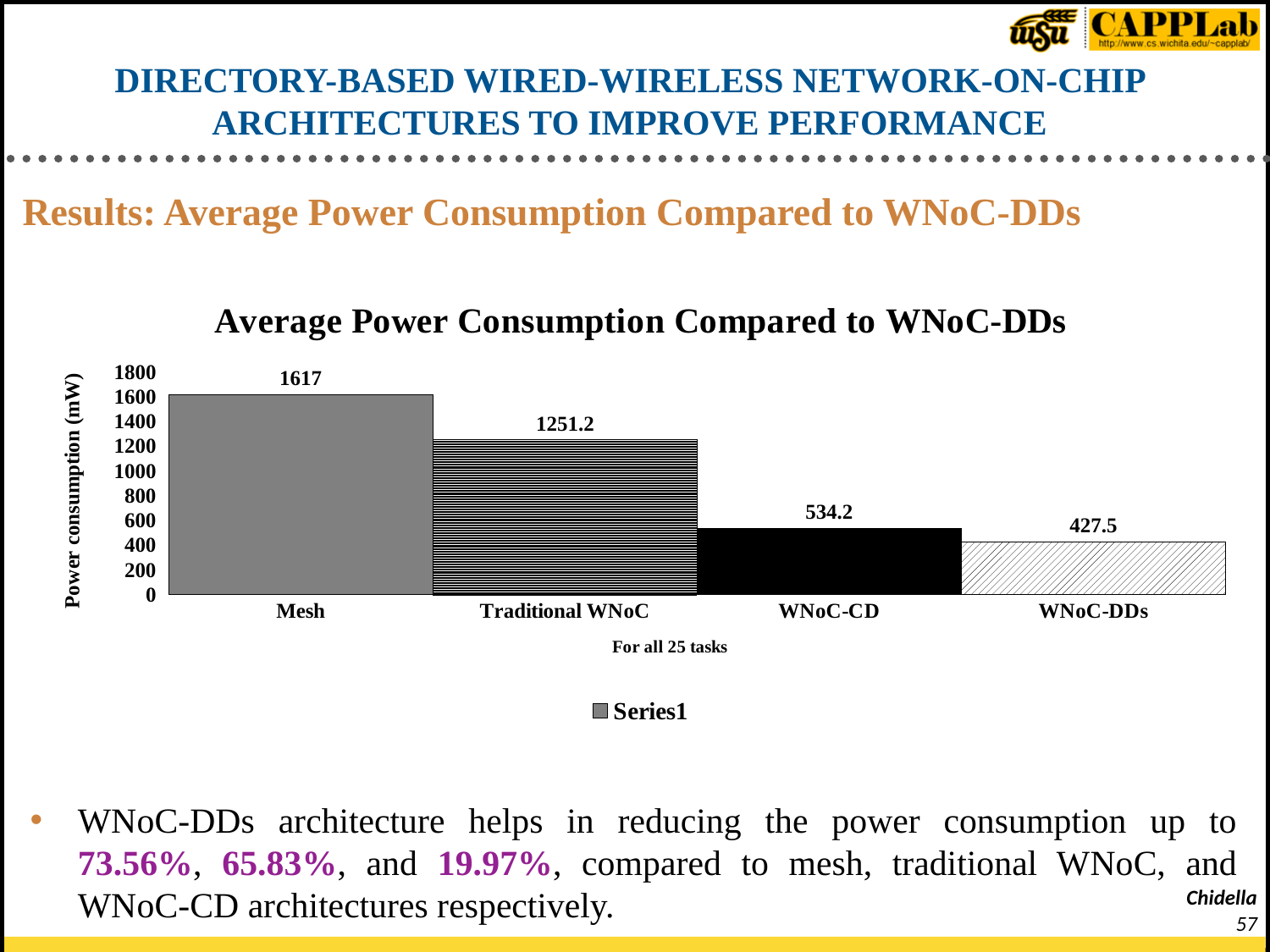
What is the label of the y axis? Power consumption (mW) What is the power consumption value for Traditional WNoC? 1251.2 What is the power consumption value for WNoC-CD? 534.2 What is the power consumption value for WNoC-DDs? 427.5 How many architectures are shown on the x axis? 4 Which has higher power consumption, Traditional WNoC or WNoC-CD? Traditional WNoC What is the difference in power consumption between WNoC-CD and WNoC-DDs? 106.7 What kind of chart is shown on the slide? Bar chart Which architecture has the lowest power consumption? WNoC-DDs Which architecture has the highest power consumption? Mesh What is the difference in power consumption between Mesh and WNoC-DDs? 1189.5 What is the power consumption value for Mesh? 1617